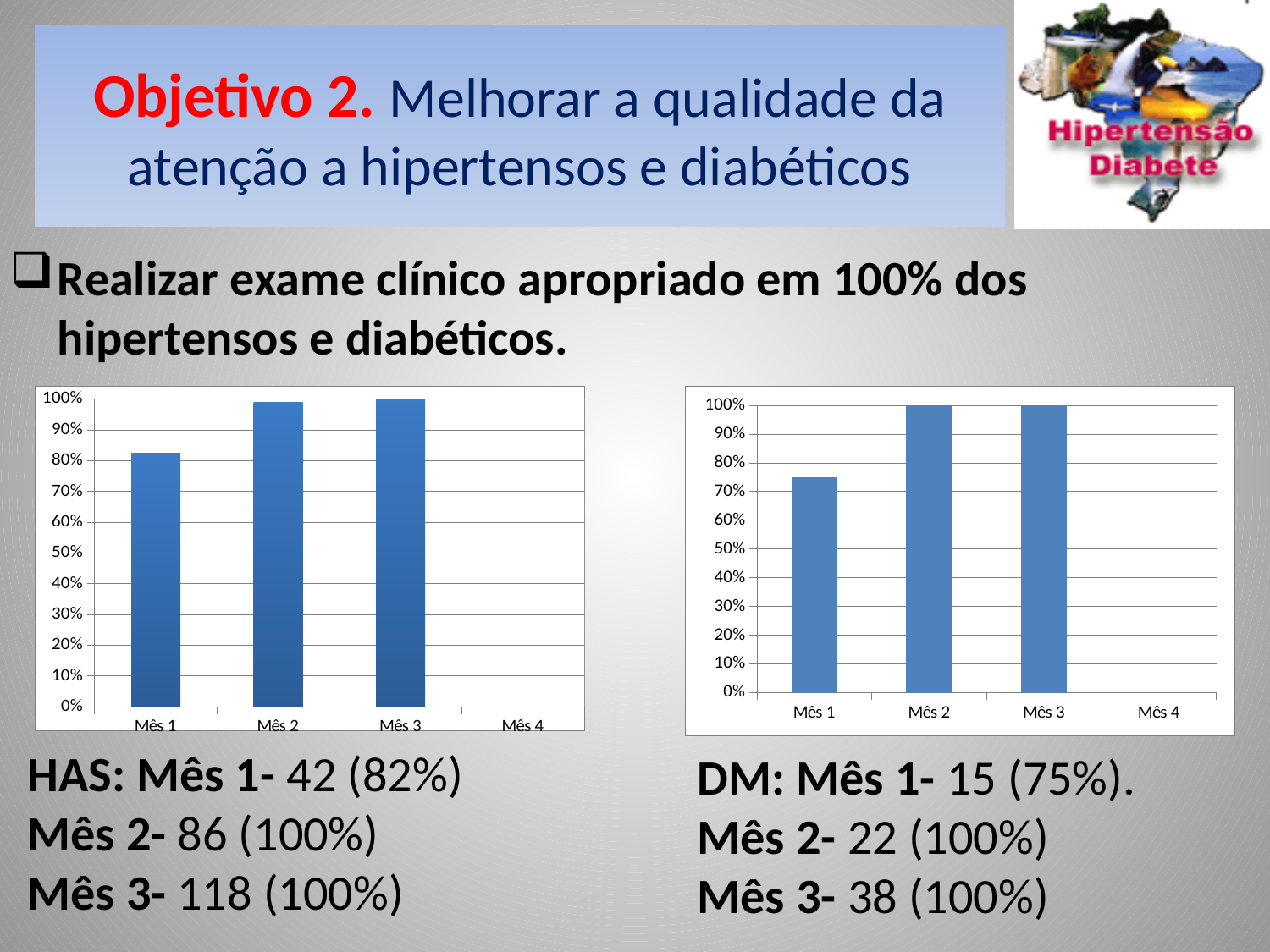
In the right chart, is the value for Mês 1 greater or less than 80%? less In the right chart, what is the value for Mês 3? 100% In the left chart, is the value for Mês 1 greater or less than 70%? greater How many month categories are shown on the x axis of the right chart? 4 According to the text below the left chart, what percentage is shown for HAS in Mês 1? 82% In the left chart, which month has the lowest bar among the months with a bar? Mês 1 According to the text below the right chart, what percentage is shown for DM in Mês 1? 75% In the left chart, do the values rise or fall from Mês 1 to Mês 3? rise In the right chart, which month category has no bar plotted? Mês 4 In the right chart, which is larger, the value for Mês 1 or the value for Mês 2? Mês 2 What kind of chart is the left chart on the slide? bar chart